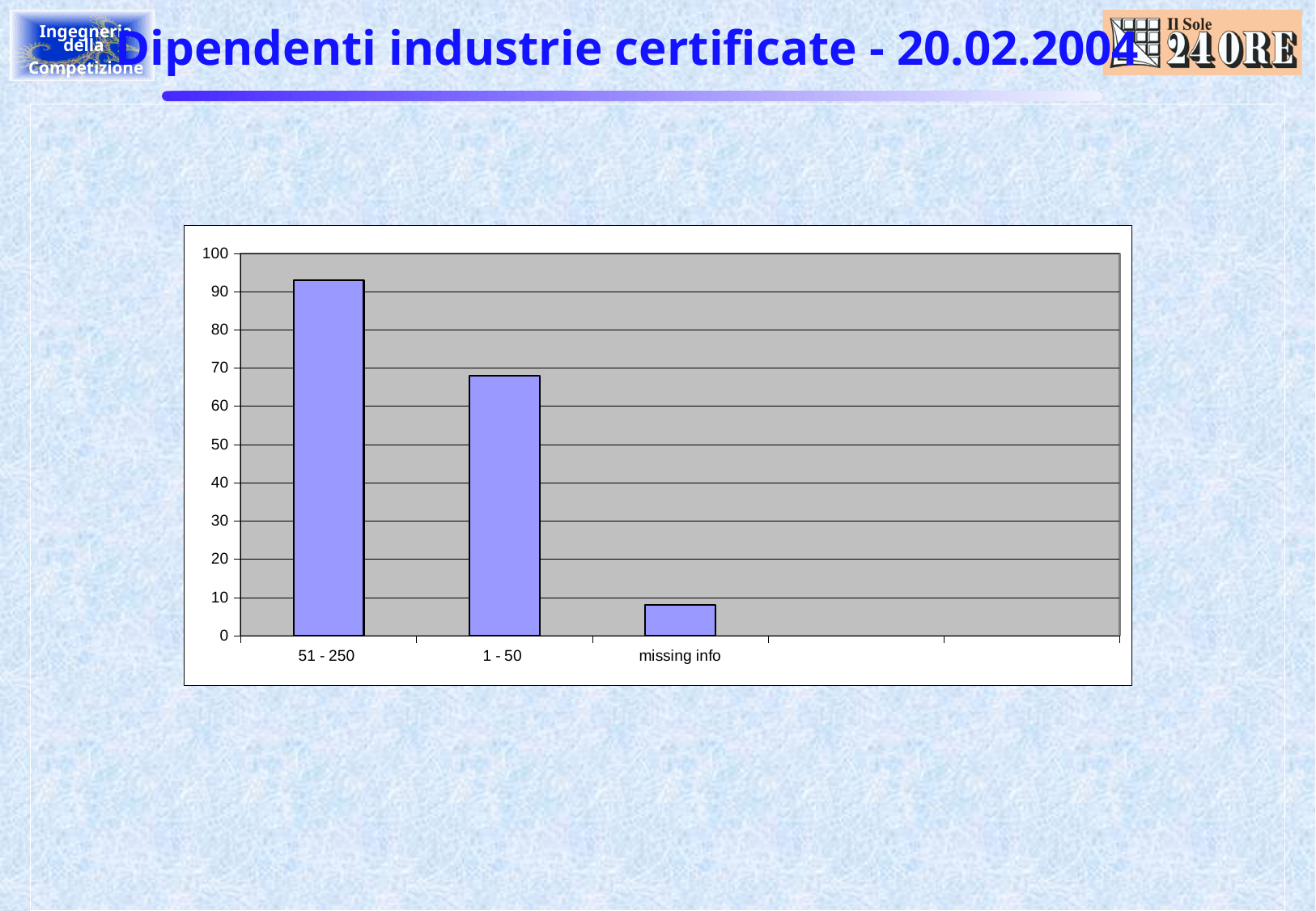
What is the title of the slide containing the chart? Dipendenti industrie certificate - 20.02.2004 Do the bar values rise or fall from left to right along the x axis? fall Which is larger, the value for 1 - 50 or the value for missing info? 1 - 50 Is the value for missing info greater or less than 10? less How many categories are shown on the x axis of the chart? 3 Which category has the lowest bar? missing info Is the value for 1 - 50 greater or less than 70? less Which is larger, the value for 51 - 250 or the value for 1 - 50? 51 - 250 Is the value for 51 - 250 greater or less than 90? greater What kind of chart is shown on the slide? bar chart Which category has the highest bar? 51 - 250